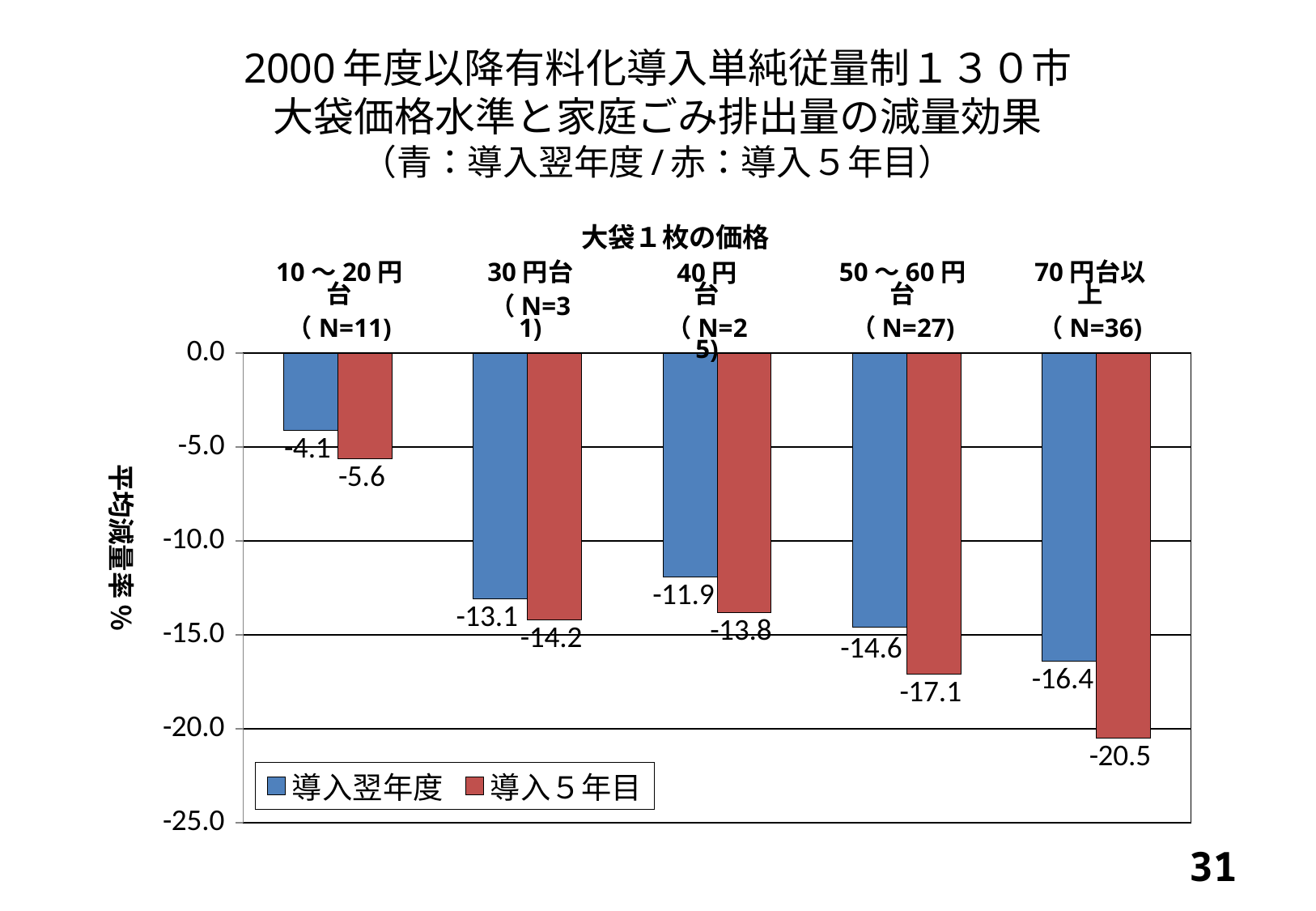
What is the value for 導入５年目 in the 70円台以上 category? -20.5 How many series does the legend list? 2 What is the value for 導入５年目 in the 40円台 category? -13.8 Which price category has the highest (least negative) value for 導入翌年度? 10～20円台 What is the value for 導入翌年度 in the 10～20円台 category? -4.1 What is the difference between the 導入翌年度 and 導入５年目 values in the 70円台以上 category? 4.1 Which colour represents 導入５年目 in the chart? Red Which price category has the lowest (most negative) value for 導入５年目? 70円台以上 Which is larger in magnitude: the 導入翌年度 value for 30円台 or the 導入翌年度 value for 40円台? 30円台 What kind of chart is shown on the slide? Bar chart How many price categories are shown on the x axis? 5 What is the value for 導入翌年度 in the 50～60円台 category? -14.6